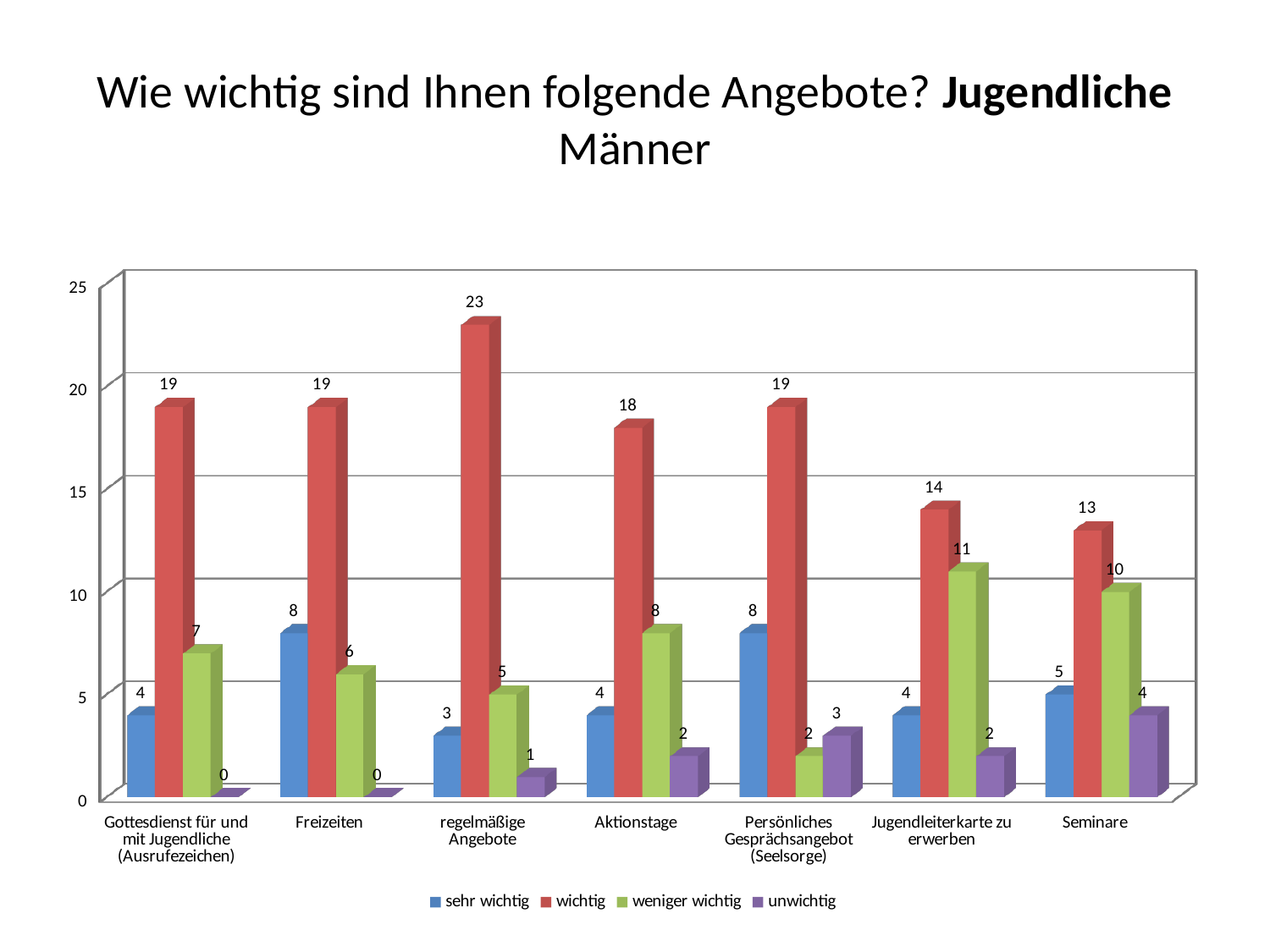
What kind of chart is shown on the slide? Bar chart Which category has the lowest value for "wichtig"? Seminare What is the value for "weniger wichtig" for Jugendleiterkarte zu erwerben? 11 Which category has the highest value for "wichtig"? regelmäßige Angebote How many categories are shown on the x axis? 7 What is the difference between the "wichtig" and "sehr wichtig" values for Aktionstage? 14 Which is larger: the "weniger wichtig" value for Seminare or for Aktionstage? Seminare How many series does the legend list? 4 What is the value for "unwichtig" for Seminare? 4 What is the total of the four values for Persönliches Gesprächsangebot (Seelsorge)? 32 What is the value for "sehr wichtig" for Freizeiten? 8 What is the value for "wichtig" for regelmäßige Angebote? 23